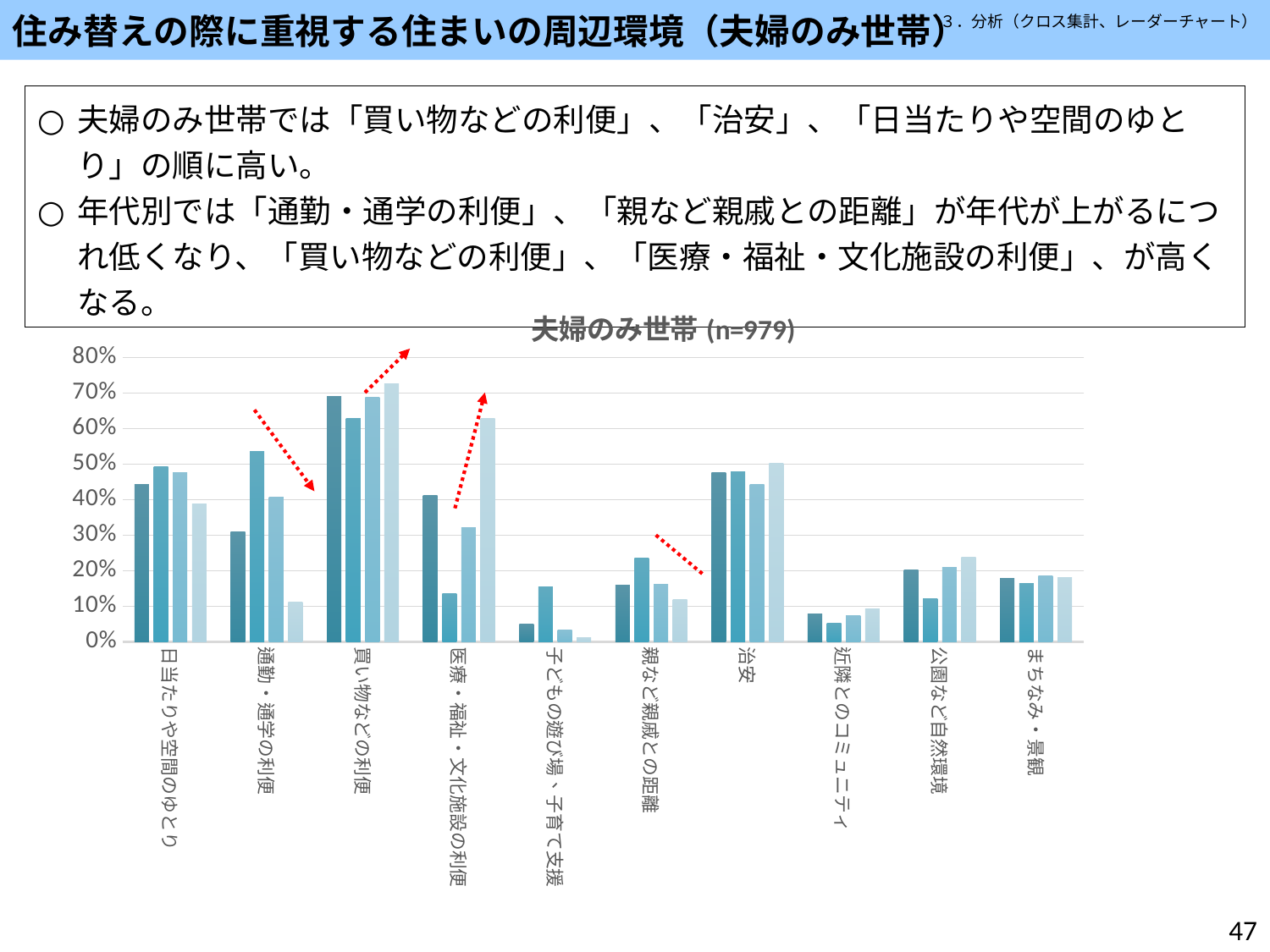
What is the title of the chart? 夫婦のみ世帯 (n=979) How many categories are shown on the x axis of the chart? 10 Which category has higher bars, 買い物などの利便 or 日当たりや空間のゆとり? 買い物などの利便 Which category has higher bars, 治安 or 公園など自然環境? 治安 Are all the bars for 治安 greater or less than 40%? greater Are all the bars for 子どもの遊び場、子育て支援 greater or less than 20%? less Is the value of the first (darkest) bar for 買い物などの利便 greater or less than 60%? greater What is the highest value shown on the y axis of the chart? 80% What kind of chart is shown on the slide? bar chart Which category has the highest bars in the chart? 買い物などの利便